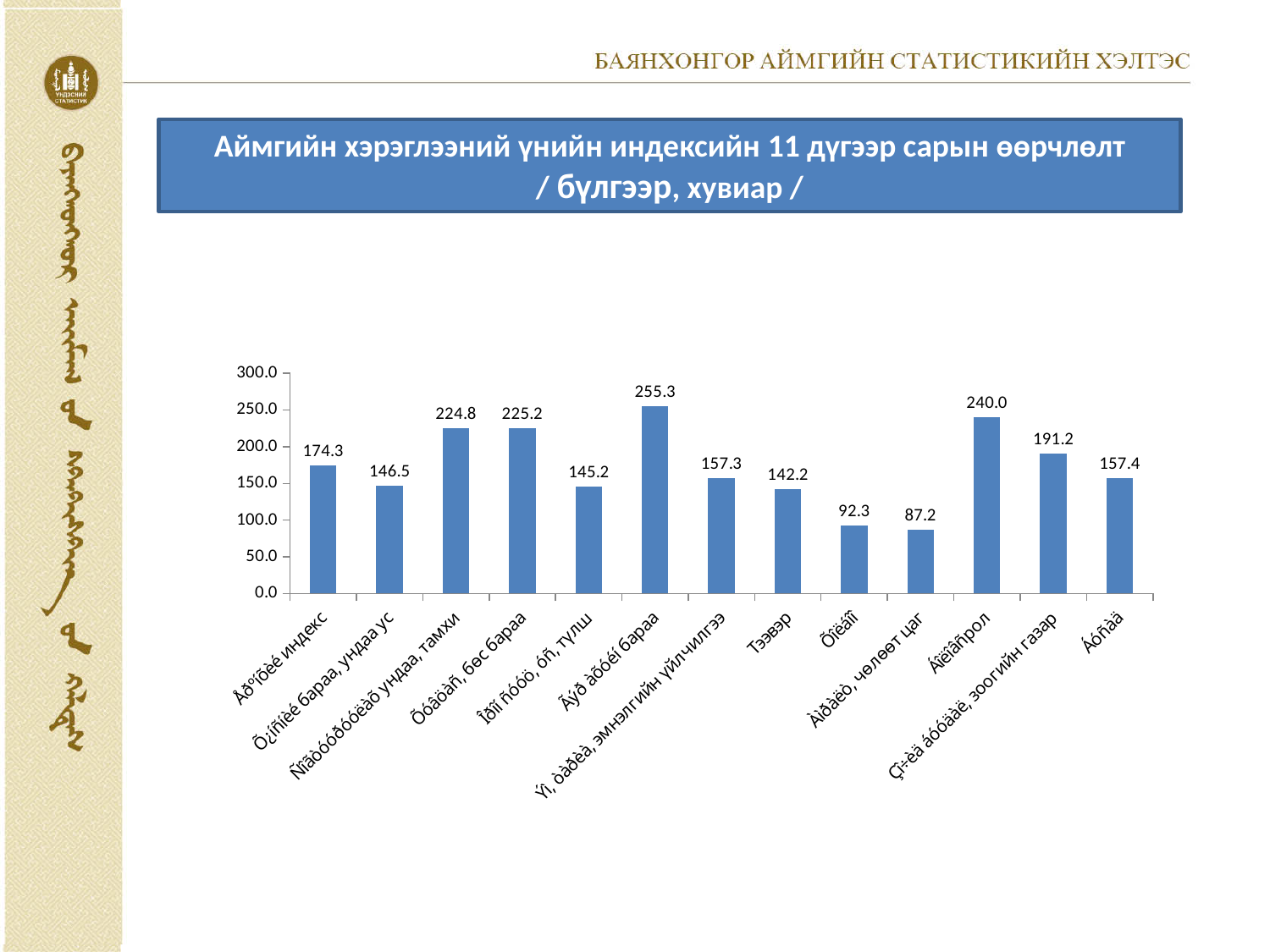
Is the value for Тээвэр greater or less than 100? greater Is the value for Тээвэр greater or less than 150? less What is the title shown in the blue box above the chart? Аймгийн хэрэглээний үнийн индексийн 11 дүгээр сарын өөрчлөлт / бүлгээр, хувиар / What is the difference between the highest value (255.3) and the lowest value (87.2) in the chart? 168.1 What is the lowest value shown in the chart? 87.2 What kind of chart is shown on the slide? bar chart How many bars in the chart have a value above 200? 4 What is the highest value shown in the chart? 255.3 How many bars (categories) does the chart show? 13 How many bars in the chart have a value below 100? 2 What is the maximum value shown on the vertical axis of the chart? 300.0 What is the value for Тээвэр? 142.2